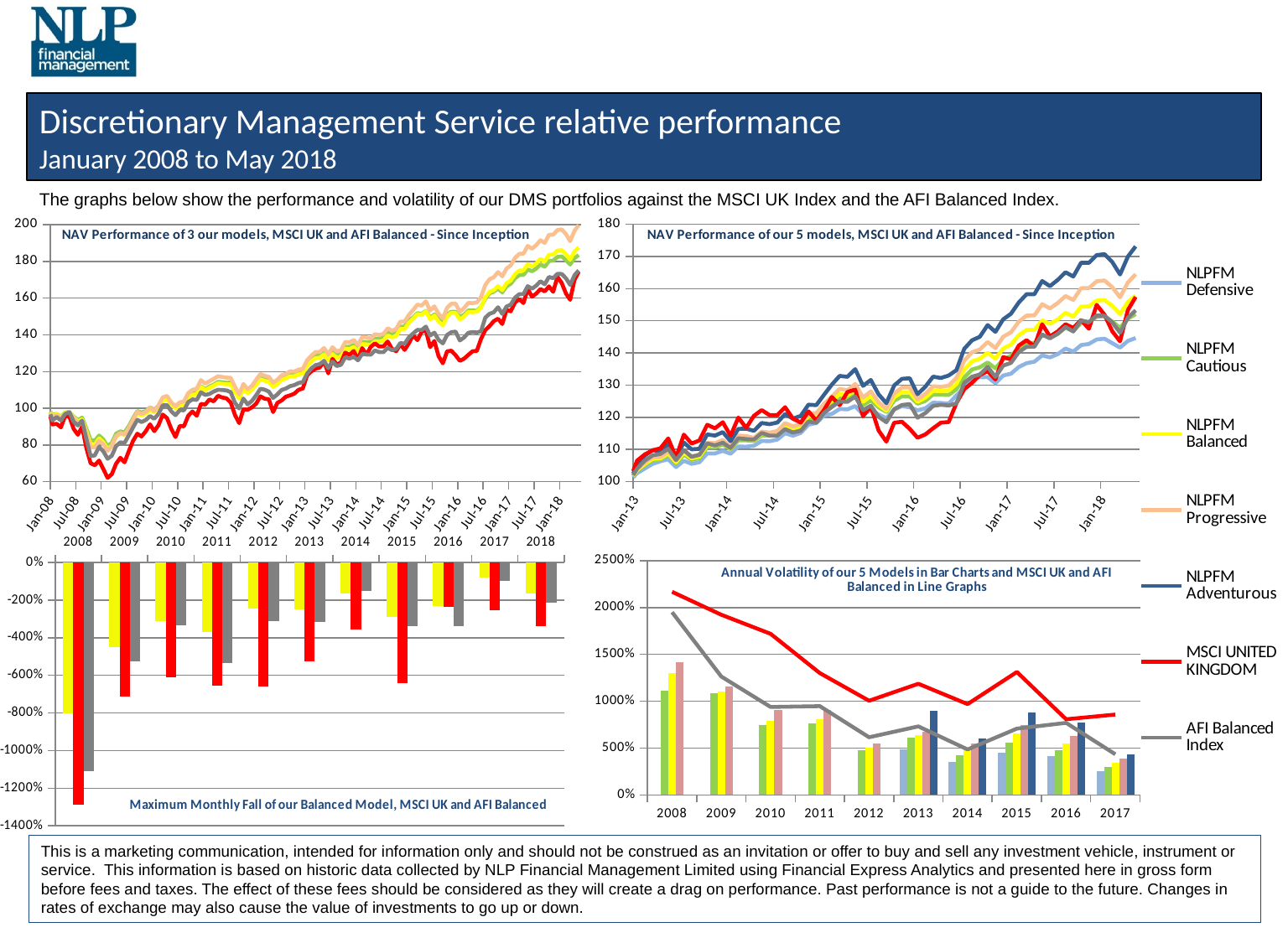
In the 'Maximum Monthly Fall of our Balanced Model, MSCI UK and AFI Balanced' chart, is the 2008 value for AFI Balanced Index greater or less than -1000%? less In the 'Annual Volatility of our 5 Models' chart, is the 2008 value for MSCI United Kingdom greater or less than 2000%? greater In the 'Annual Volatility of our 5 Models' chart, how many years are shown on the x axis? 10 What kind of chart is the 'NAV Performance of 3 our models, MSCI UK and AFI Balanced - Since Inception' chart? line chart In the 'Annual Volatility of our 5 Models' chart, does the MSCI United Kingdom line rise or fall from 2008 to 2012? fall In the 'NAV Performance of 3 our models, MSCI UK and AFI Balanced - Since Inception' chart, is the lowest point of the MSCI United Kingdom line in 2009 greater or less than 80? less What kind of chart is the 'Maximum Monthly Fall of our Balanced Model, MSCI UK and AFI Balanced' chart? bar chart In the 'Maximum Monthly Fall of our Balanced Model, MSCI UK and AFI Balanced' chart, which year shows the largest fall for MSCI United Kingdom? 2008 In the 'NAV Performance of our 5 models, MSCI UK and AFI Balanced - Since Inception' chart, which series is highest at the end of the period? NLPFM Adventurous How many series does the legend on the right of the slide list? 7